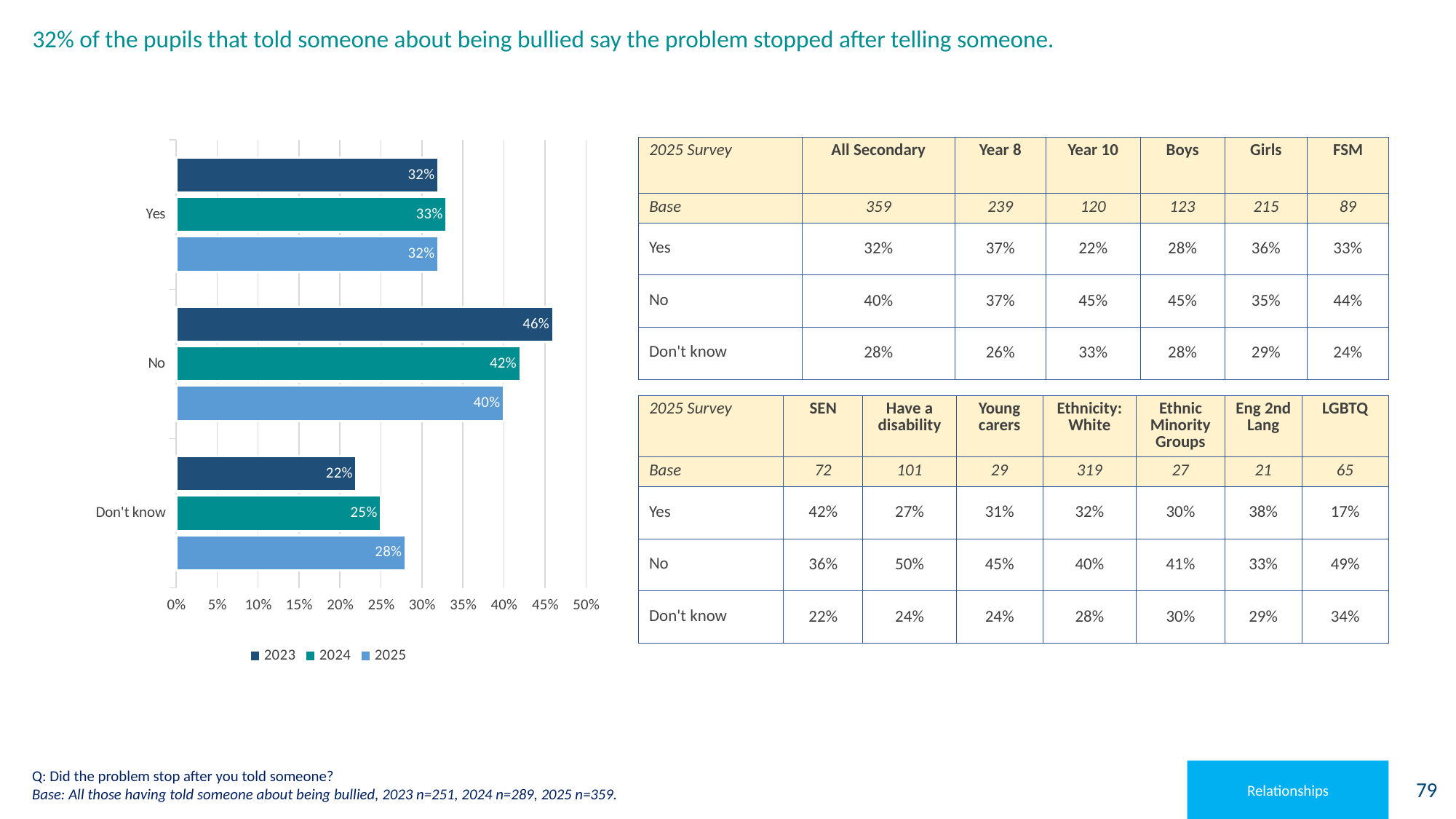
Is the 2023 value for 'No' greater or less than 45%? greater What kind of chart is shown on the slide? Bar chart What is the difference between the 2023 and 2025 values for 'No'? 6% Do the values for 'Don't know' rise or fall from 2023 to 2025? Rise What is the value for 'Yes' in the 2024 series? 33% How many series does the legend list? 3 Which category has the highest value in the 2023 series? No What is the value for 'Don't know' in the 2025 series? 28% Which category has the lowest value in the 2024 series? Don't know Which is larger: the 2024 value for 'Don't know' or the 2025 value for 'Don't know'? 2025 What is the value for 'No' in the 2023 series? 46% How many categories are shown on the chart? 3